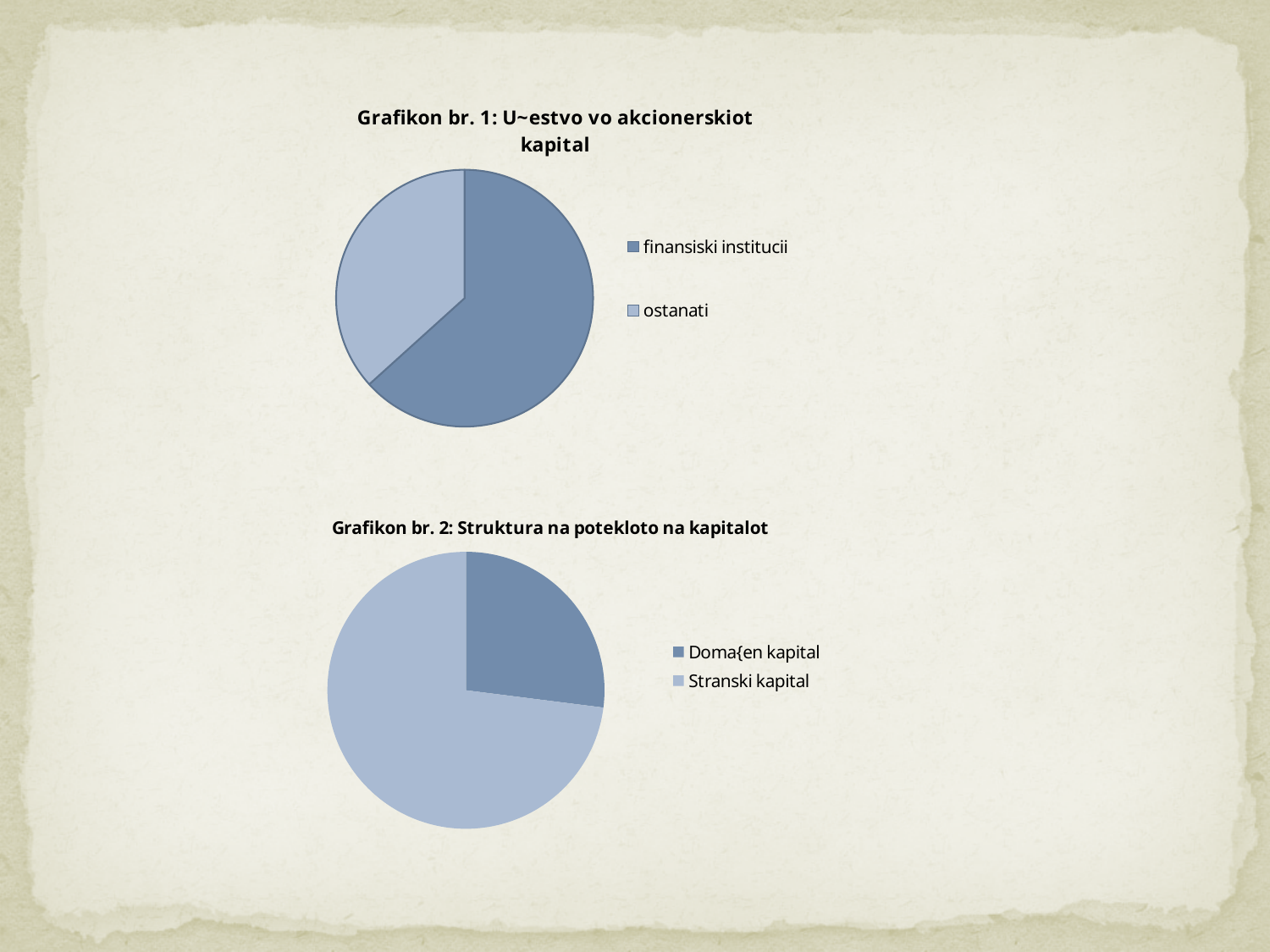
In 'Grafikon br. 1: U~estvo vo akcionerskiot kapital', which is larger, finansiski institucii or ostanati? finansiski institucii In 'Grafikon br. 2: Struktura na potekloto na kapitalot', which category has the largest slice? Stranski kapital In 'Grafikon br. 1: U~estvo vo akcionerskiot kapital', which category has the largest slice? finansiski institucii What are the two legend entries of the bottom chart on the slide? Doma{en kapital, Stranski kapital What kind of chart is 'Grafikon br. 2: Struktura na potekloto na kapitalot'? pie chart In 'Grafikon br. 2: Struktura na potekloto na kapitalot', how many slices does the pie have? 2 What kind of chart is 'Grafikon br. 1: U~estvo vo akcionerskiot kapital'? pie chart In 'Grafikon br. 1: U~estvo vo akcionerskiot kapital', how many slices does the pie have? 2 How many entries does the legend of 'Grafikon br. 1: U~estvo vo akcionerskiot kapital' list? 2 How many entries does the legend of 'Grafikon br. 2: Struktura na potekloto na kapitalot' list? 2 In 'Grafikon br. 2: Struktura na potekloto na kapitalot', which is larger, Doma{en kapital or Stranski kapital? Stranski kapital In 'Grafikon br. 1: U~estvo vo akcionerskiot kapital', which category has the smallest slice? ostanati